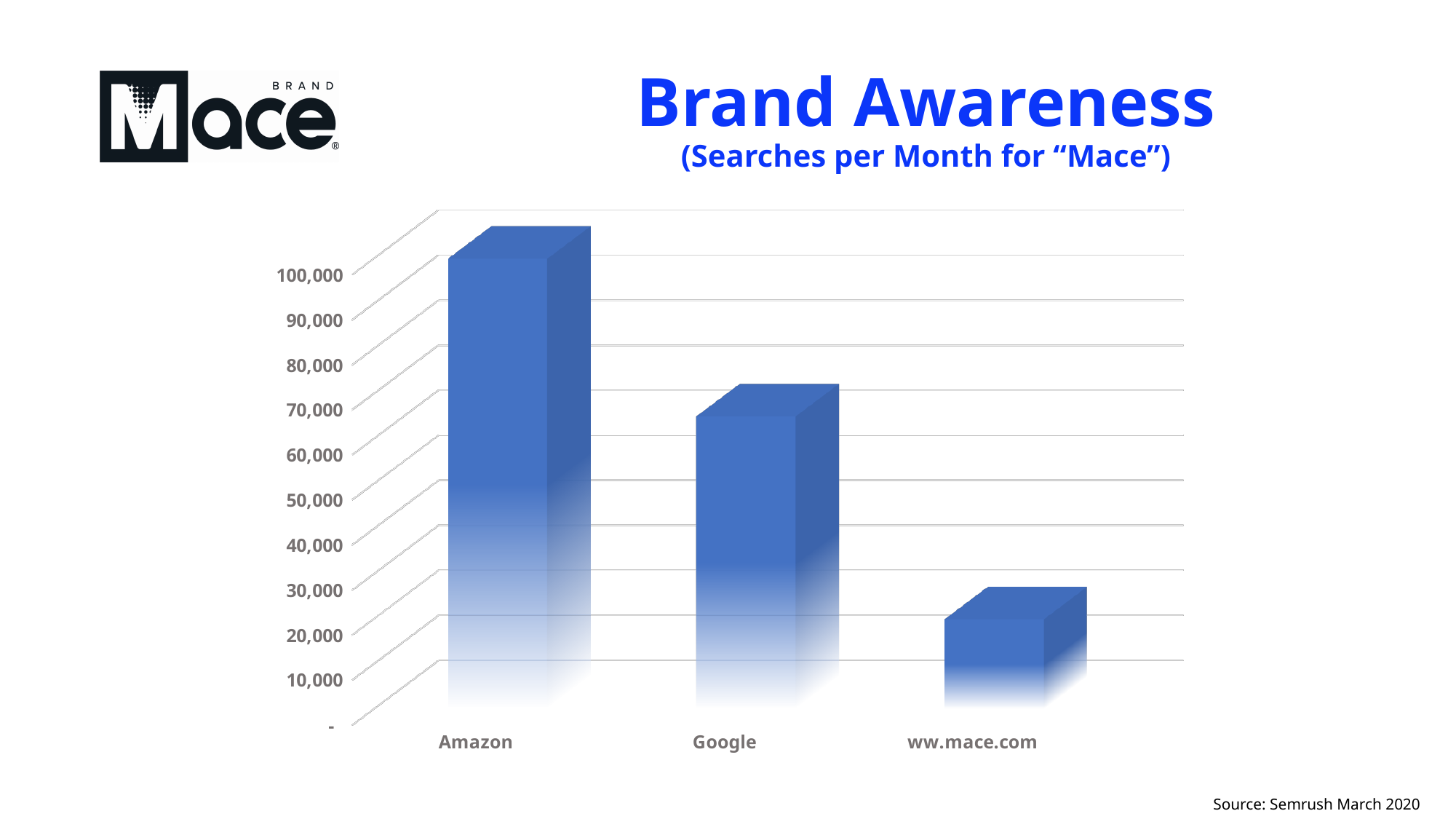
Is the value for Amazon greater or less than 90,000? greater How many categories are shown on the x axis of the chart? 3 Is the value for Google greater or less than 80,000? less Is the value for ww.mace.com greater or less than 30,000? less Which has more searches per month, Google or ww.mace.com? Google What kind of chart is shown on the slide? bar chart Which category has the lowest number of searches per month? ww.mace.com What is the title of the chart on the slide? Brand Awareness (Searches per Month for "Mace") Which has more searches per month, Amazon or Google? Amazon Do the values rise or fall moving from left to right across the categories? fall Which category has the highest number of searches per month? Amazon